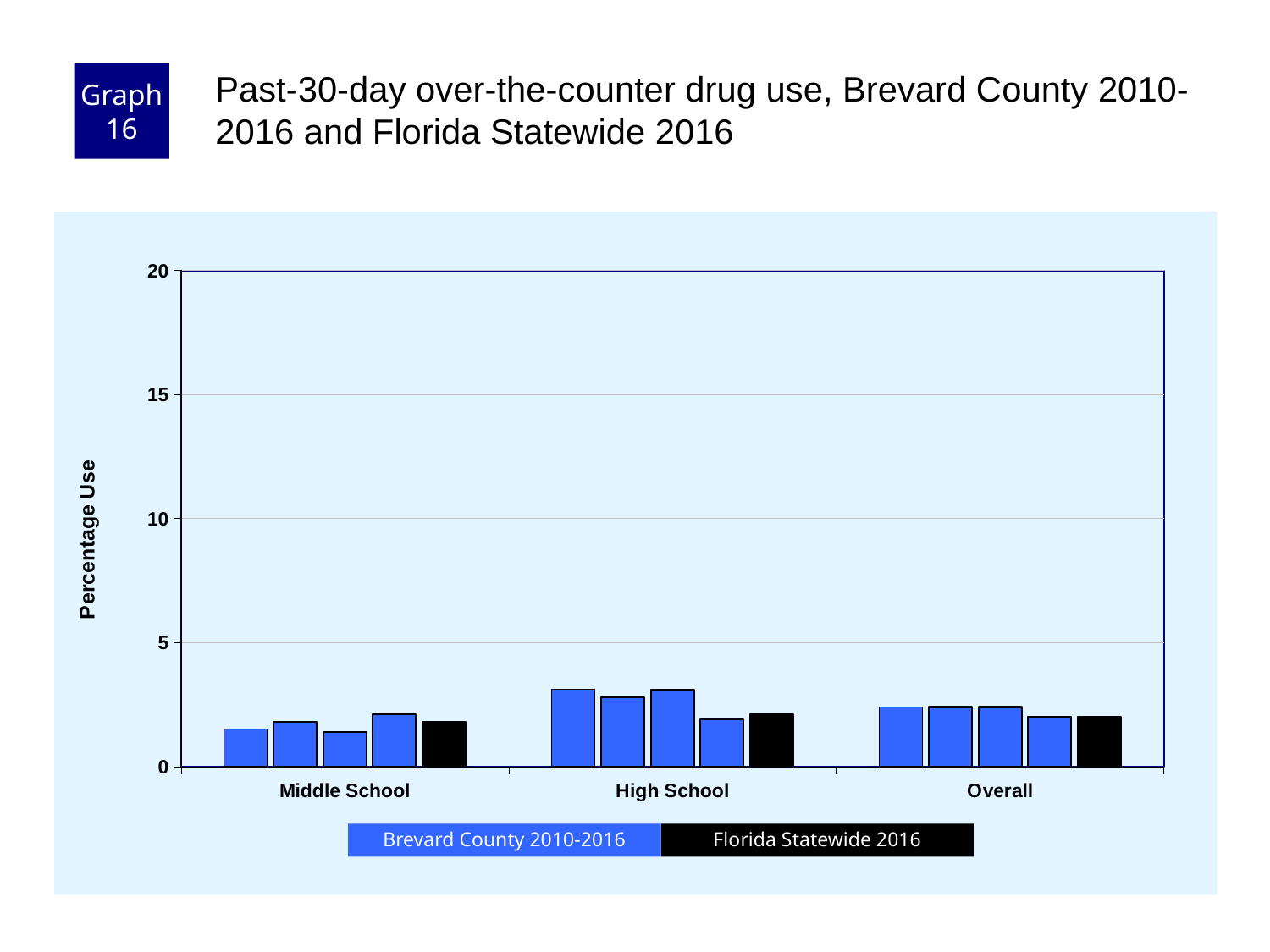
Is the Florida Statewide 2016 value for High School greater or less than 5? less Which category on the x axis contains the tallest bar in the chart? High School Which series is shown in black in the chart? Florida Statewide 2016 Is the Florida Statewide 2016 value for Middle School greater or less than 5? less What kind of chart is shown on the slide? bar chart Is the tallest Brevard County 2010-2016 bar for High School greater or less than 5? less How many categories are shown on the x axis of the chart? 3 What is the label on the vertical axis of the chart? Percentage Use How many series does the chart's legend list? 2 Which category on the x axis contains the shortest bar in the chart? Middle School